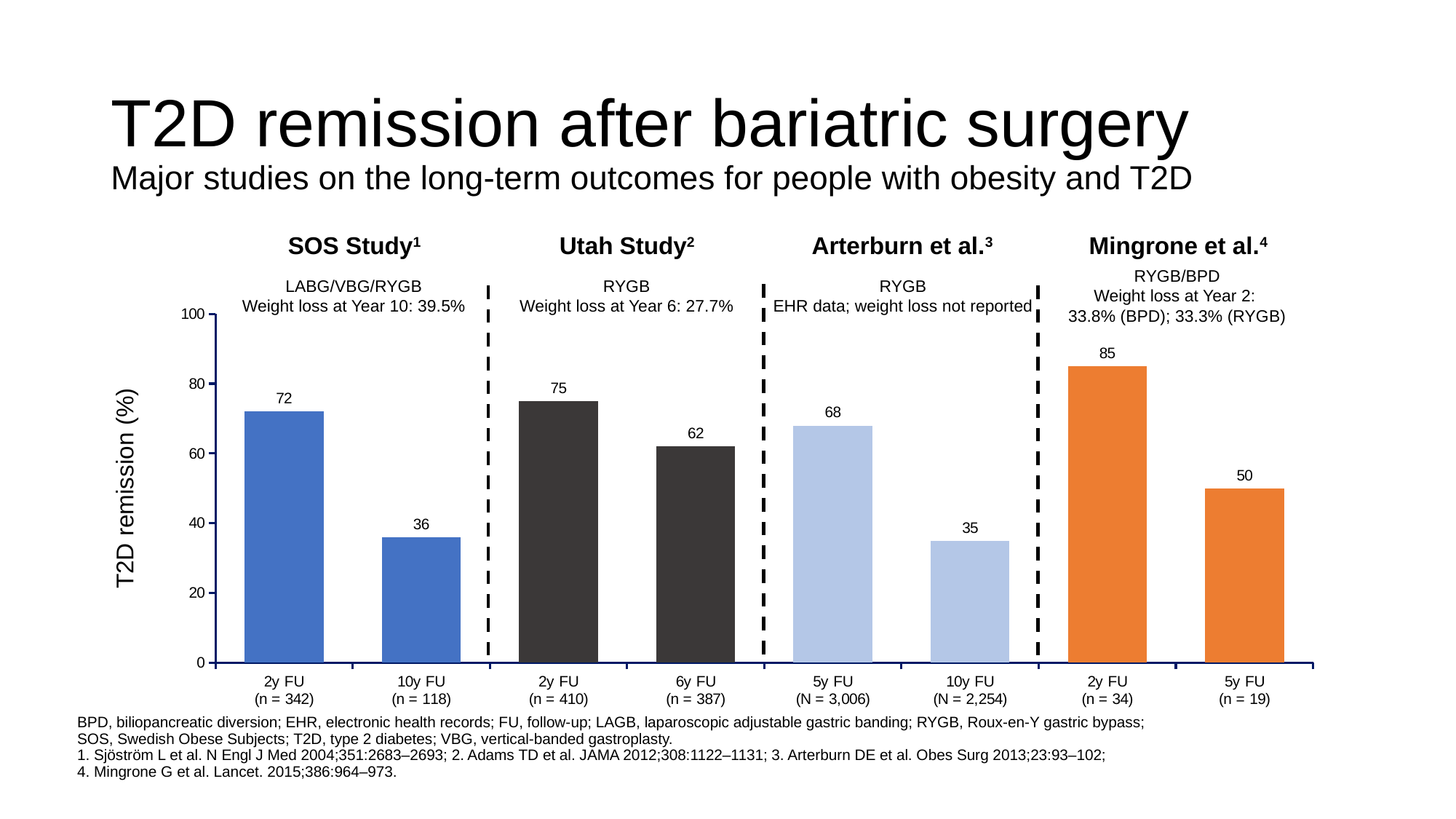
What is the sample size (n) for the Mingrone et al. 5y FU bar? n = 19 Which is larger: the Utah Study 2y FU value or the Arterburn et al. 5y FU value? Utah Study 2y FU What is the T2D remission (%) for Mingrone et al. at 2y FU? 85 Within each study, does T2D remission rise or fall from the earlier to the later follow-up? Fall What is the T2D remission (%) for the SOS Study at 2y FU? 72 What is the T2D remission (%) for Arterburn et al. at 10y FU? 35 How many bars are plotted in the chart? 8 What is the difference in T2D remission (%) between the SOS Study 2y FU and 10y FU bars? 36 What is the T2D remission (%) for the Utah Study at 6y FU? 62 What kind of chart is shown on the slide? Bar chart Which bar shows the highest T2D remission (%)? Mingrone et al. 2y FU Which bar shows the lowest T2D remission (%)? Arterburn et al. 10y FU